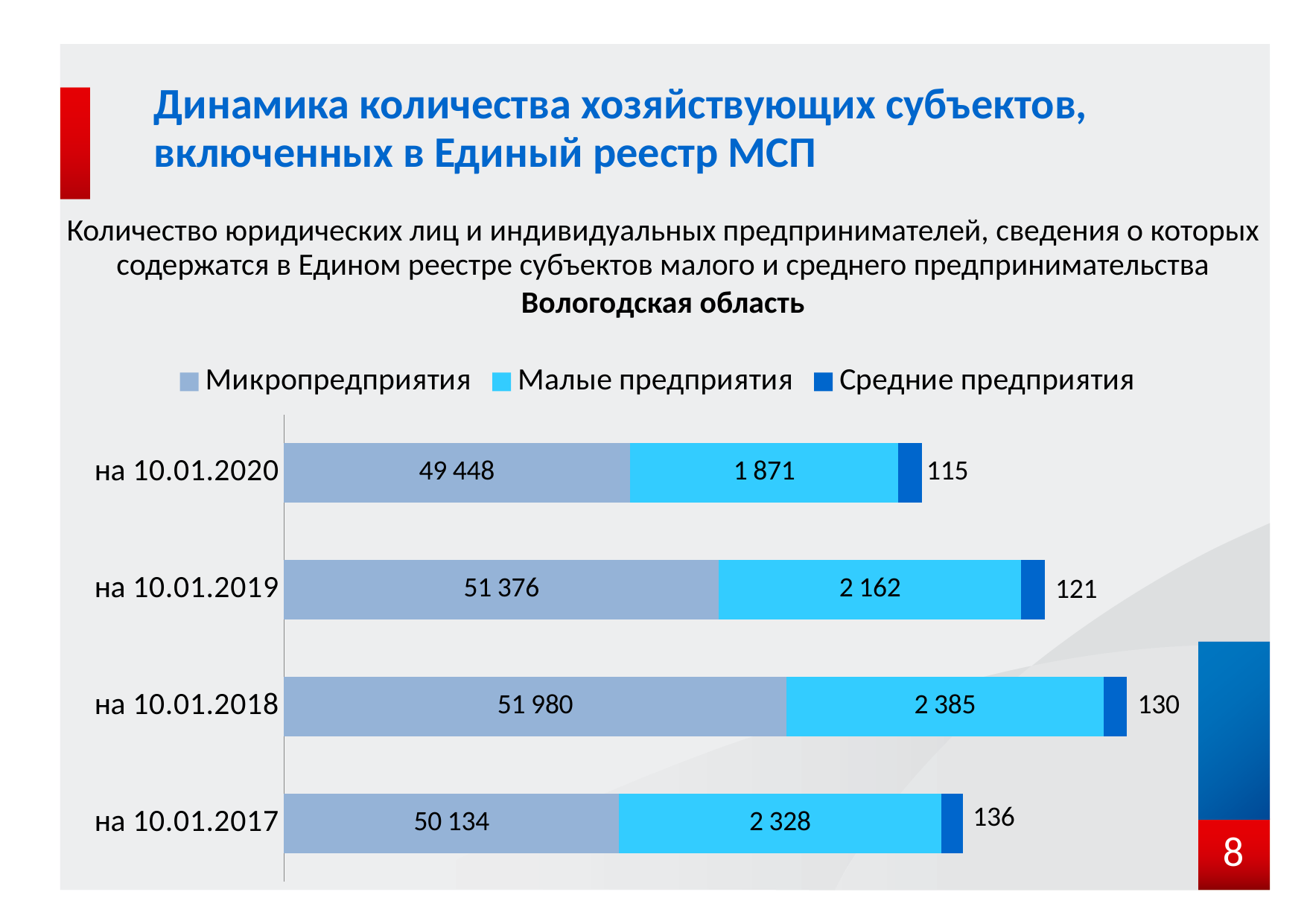
What is the difference between the Микропредприятия values на 10.01.2018 and на 10.01.2020? 2 532 How many series does the legend list? 3 What is the difference between the Средние предприятия values на 10.01.2017 and на 10.01.2020? 21 What is the value for Микропредприятия на 10.01.2020? 49 448 What is the value for Малые предприятия на 10.01.2018? 2 385 On which date is the value for Микропредприятия highest? на 10.01.2018 On which date is the value for Средние предприятия lowest? на 10.01.2020 Which is larger: Малые предприятия на 10.01.2017 or на 10.01.2019? на 10.01.2017 What is the value for Средние предприятия на 10.01.2019? 121 What is the total of the stacked bar for на 10.01.2020? 51 434 How many dates (categories) are shown on the chart? 4 What kind of chart is shown on the slide? Stacked bar chart